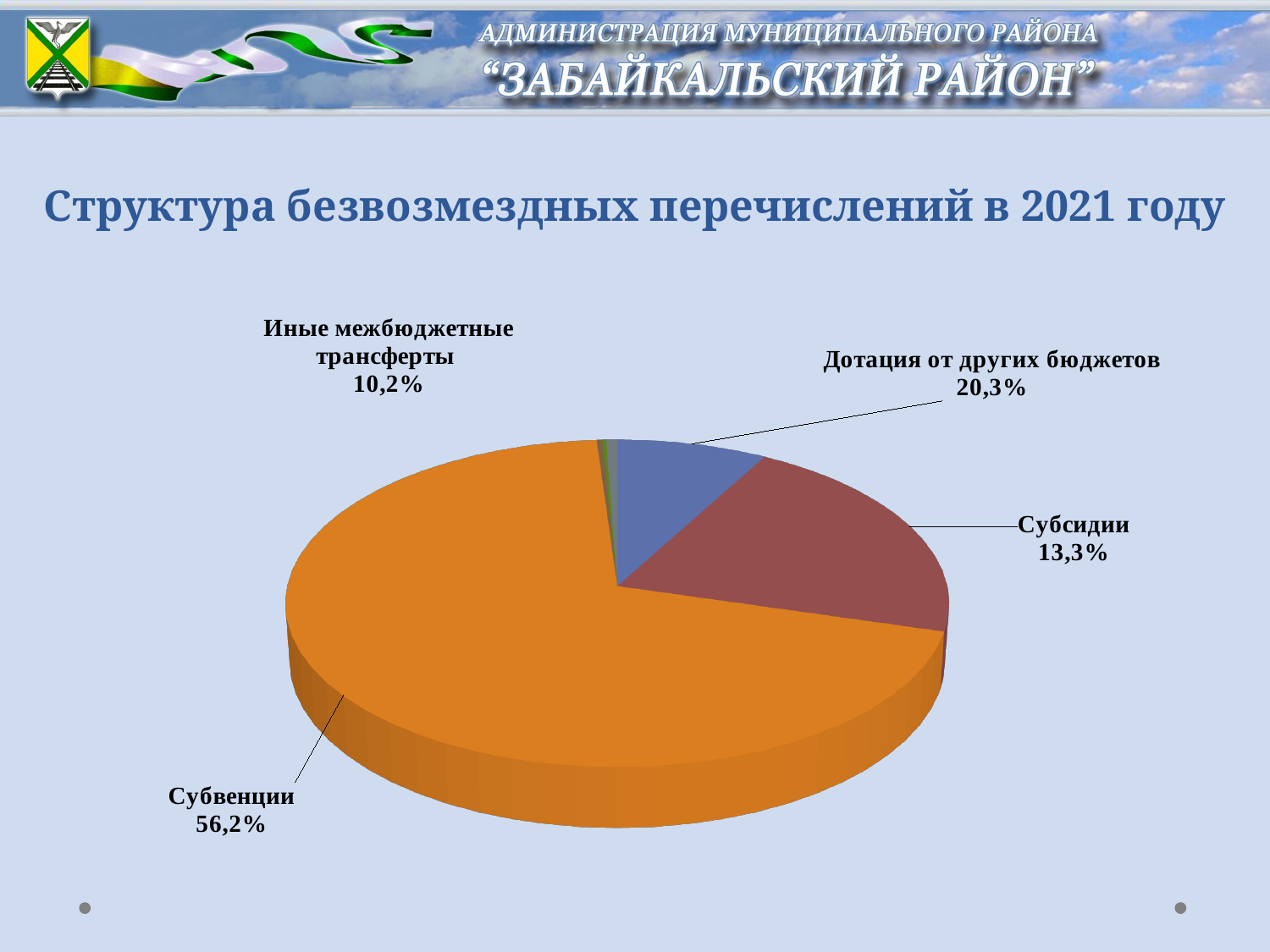
Which labeled category has the smallest share of the pie? Иные межбюджетные трансферты Which category has the largest share of the pie? Субвенции Which is larger, the share for Субсидии or the share for Иные межбюджетные трансферты? Субсидии What is the difference in percentage points between Субвенции and Дотация от других бюджетов? 35,9 What share of the pie does Субвенции account for? 56,2% What is the value shown for Иные межбюджетные трансферты? 10,2% What is the title of the slide? Структура безвозмездных перечислений в 2021 году What kind of chart is shown on the slide? Pie chart What is the value shown for Субсидии? 13,3% What is the difference in percentage points between Дотация от других бюджетов and Субсидии? 7,0 What is the value shown for Дотация от других бюджетов? 20,3%